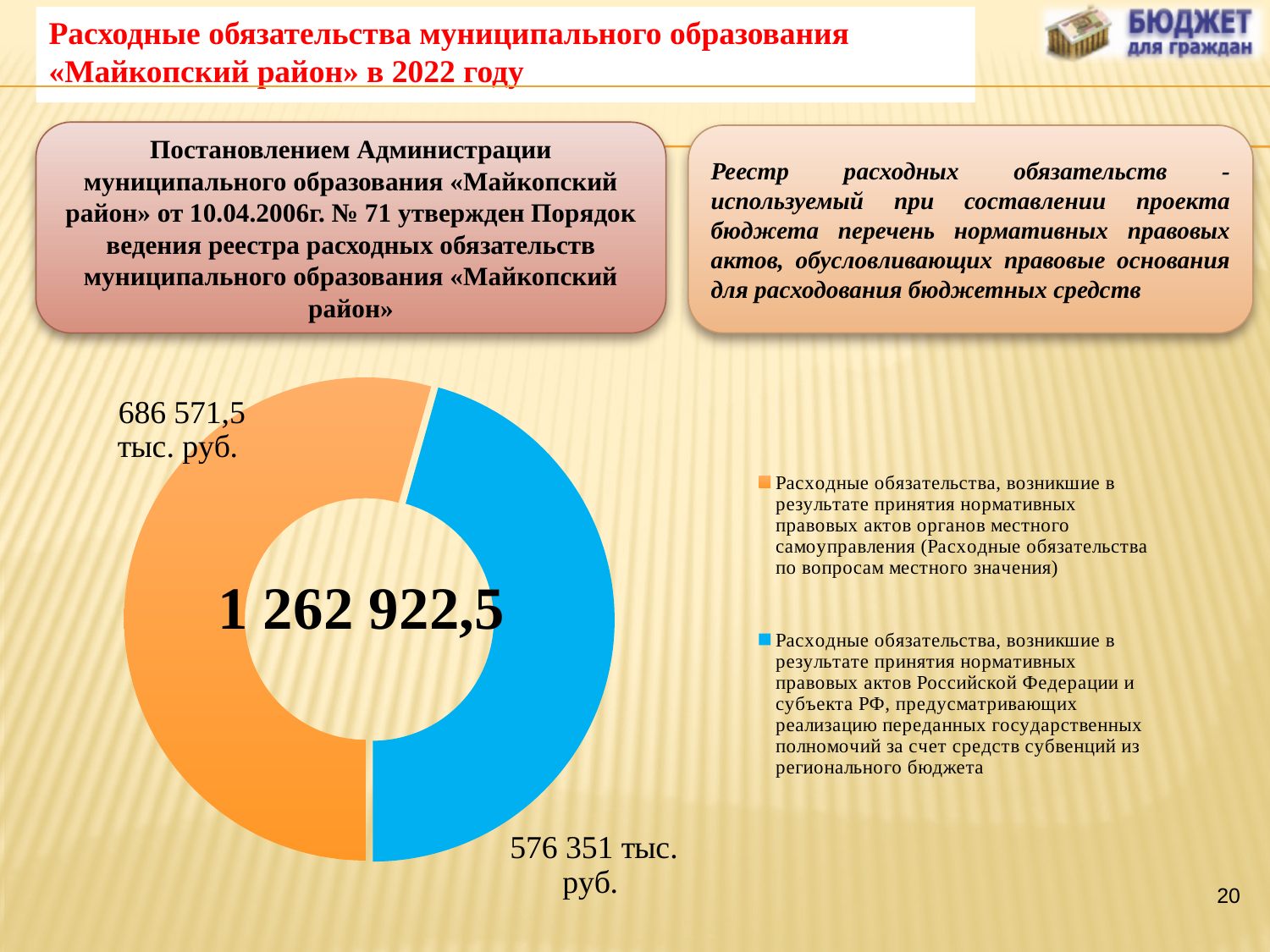
What is the value of the blue slice (расходные обязательства за счет средств субвенций из регионального бюджета)? 576 351 тыс. руб. What is the difference between the two slices of the chart, in тыс. руб.? 110 220,5 тыс. руб. Which category has the larger value: расходные обязательства по вопросам местного значения or расходные обязательства за счет субвенций из регионального бюджета? Расходные обязательства по вопросам местного значения How many entries does the chart legend list? 2 What type of chart is shown on the slide? doughnut (pie) chart What total value is printed in the centre of the doughnut chart? 1 262 922,5 Which slice of the chart is the largest? Расходные обязательства по вопросам местного значения (686 571,5 тыс. руб.) What colour represents расходные обязательства по вопросам местного значения? orange How many slices does the doughnut chart have? 2 What is the value of the orange slice (расходные обязательства по вопросам местного значения)? 686 571,5 тыс. руб. What colour represents расходные обязательства, возникшие в результате принятия нормативных правовых актов Российской Федерации и субъекта РФ? blue Which slice of the chart is the smallest? Расходные обязательства за счет средств субвенций из регионального бюджета (576 351 тыс. руб.)